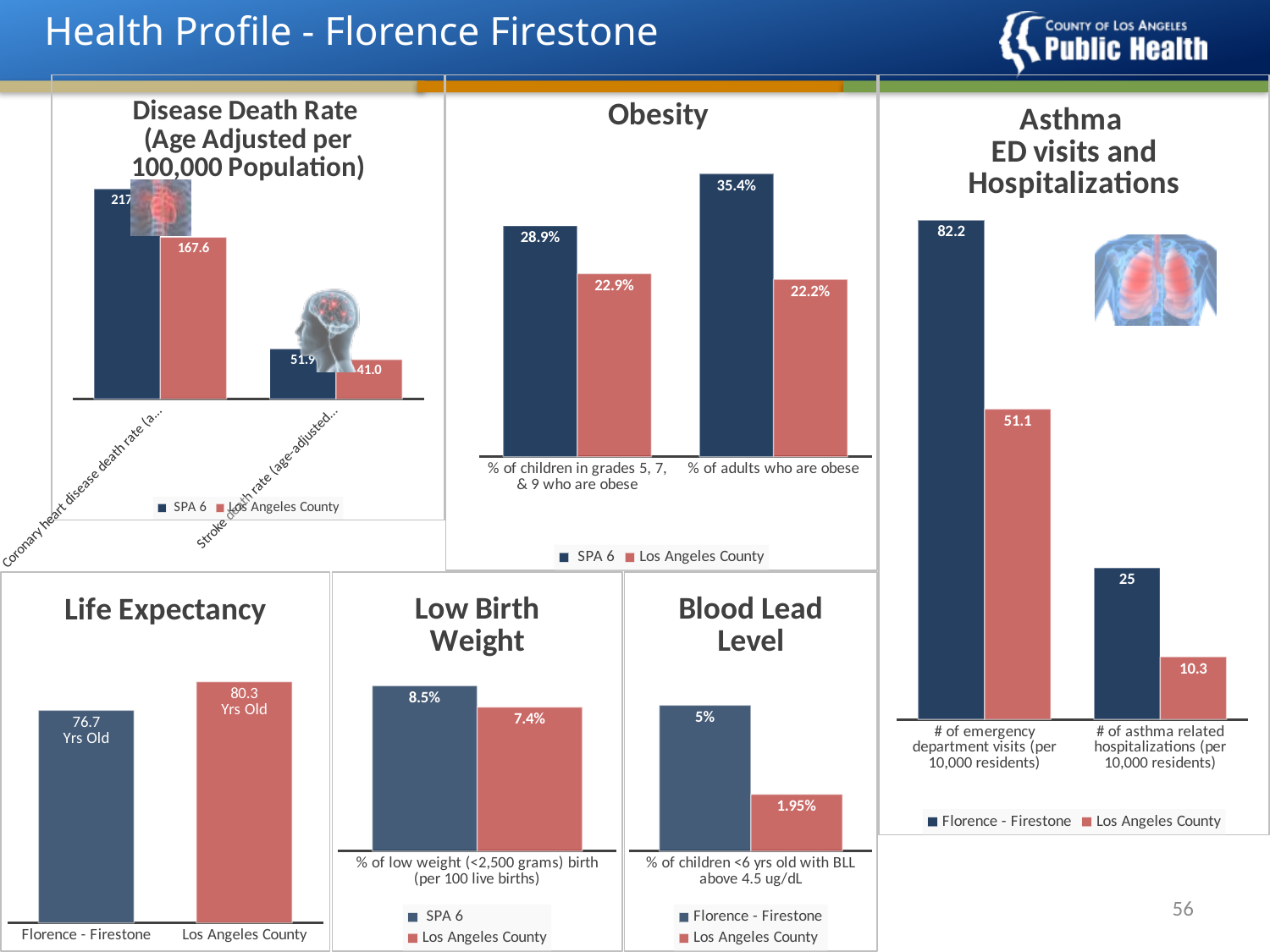
In the Asthma ED visits and Hospitalizations chart, which bar is the highest? Florence - Firestone, # of emergency department visits In the Asthma ED visits and Hospitalizations chart, what is the Los Angeles County value for asthma related hospitalizations per 10,000 residents? 10.3 In the Life Expectancy chart, what is the life expectancy for Los Angeles County? 80.3 Yrs Old In the Obesity chart, what is the Los Angeles County value for the percentage of children in grades 5, 7, & 9 who are obese? 22.9% In the Life Expectancy chart, which has the higher life expectancy, Florence - Firestone or Los Angeles County? Los Angeles County In the Disease Death Rate chart, what is the Los Angeles County value for the coronary heart disease death rate? 167.6 In the Blood Lead Level chart, what is the value for Los Angeles County? 1.95% In the Obesity chart, what is the value for SPA 6 for the percentage of adults who are obese? 35.4% In the Obesity chart, what is the difference between the SPA 6 and Los Angeles County values for adults who are obese? 13.2% In the Low Birth Weight chart, what is the value for SPA 6? 8.5% In the Asthma ED visits and Hospitalizations chart, what is the Florence - Firestone value for emergency department visits per 10,000 residents? 82.2 How many series does the legend of the Asthma ED visits and Hospitalizations chart list? 2